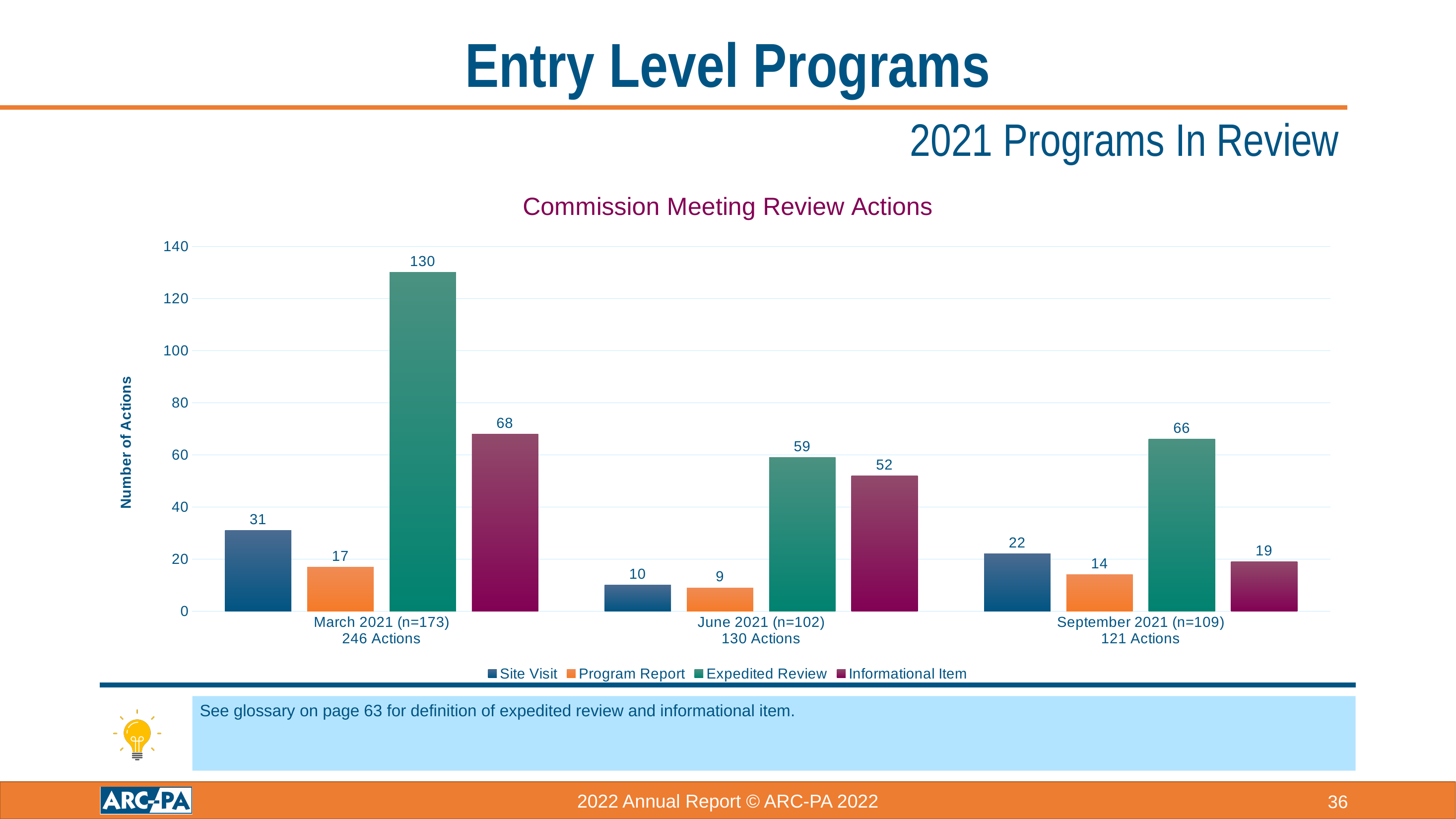
What is the value for Site Visit in June 2021 (n=102)? 10 What is the value for Informational Item in September 2021 (n=109)? 19 What is the difference between the Informational Item values for March 2021 and June 2021? 16 Which meeting has the lowest Program Report value? June 2021 (n=102) Which is larger: Site Visit in March 2021 or Site Visit in September 2021? Site Visit in March 2021 What is the title of the chart? Commission Meeting Review Actions How many series does the legend list? 4 What is the value for Expedited Review in March 2021 (n=173)? 130 Is the value for Expedited Review in September 2021 greater or less than 80? less Which meeting has the highest Expedited Review value? March 2021 (n=173) What kind of chart is shown? bar chart How many meeting categories are shown on the x axis? 3